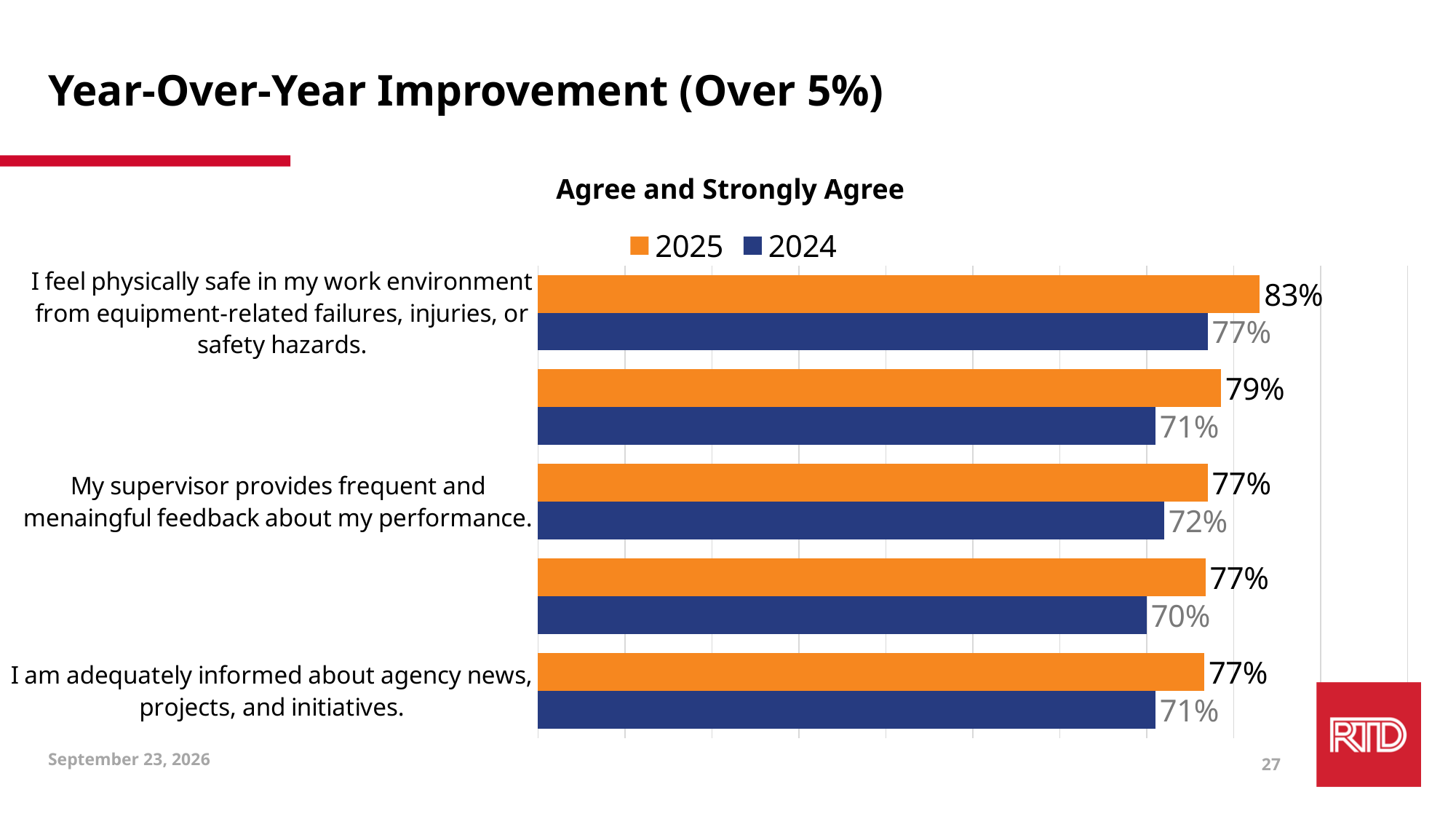
What is the 2024 value for "I feel physically safe in my work environment from equipment-related failures, injuries, or safety hazards"? 77% What is the 2025 value for "I feel physically safe in my work environment from equipment-related failures, injuries, or safety hazards"? 83% What is the difference between the 2025 and 2024 values for "I feel physically safe in my work environment from equipment-related failures, injuries, or safety hazards"? 6% What is the difference between the 2025 and 2024 values for "I am adequately informed about agency news, projects, and initiatives"? 6% What is the 2025 value for "My supervisor provides frequent and meaningful feedback about my performance"? 77% Which statement has the highest 2025 value? I feel physically safe in my work environment from equipment-related failures, injuries, or safety hazards. How many series does the legend list? 2 For "My supervisor provides frequent and meaningful feedback about my performance", which year has the larger value, 2025 or 2024? 2025 What is the title of the chart? Agree and Strongly Agree What is the 2024 value for "I am adequately informed about agency news, projects, and initiatives"? 71% What is the 2024 value for "My supervisor provides frequent and meaningful feedback about my performance"? 72% What kind of chart is shown on the slide? Bar chart